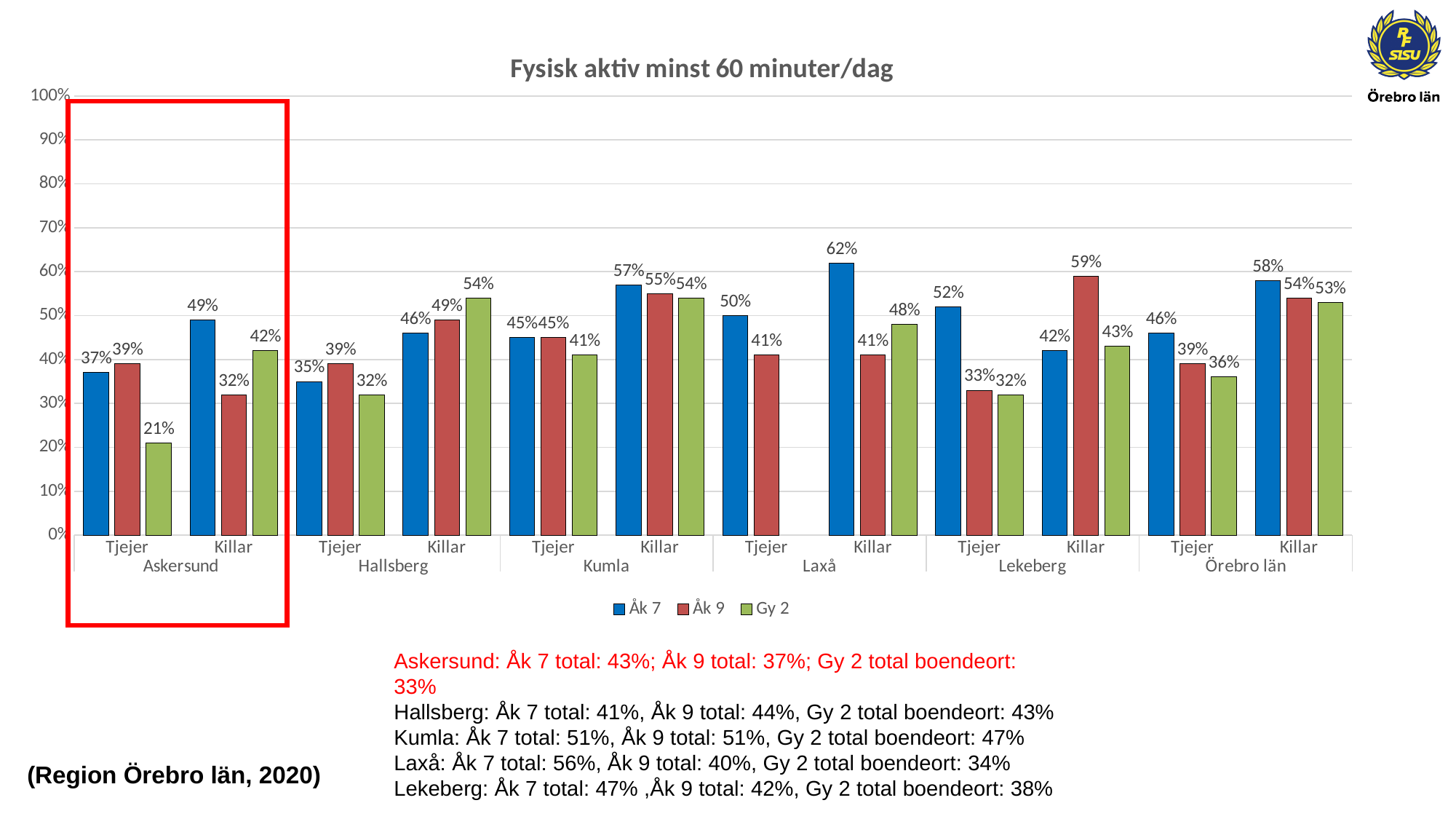
How many municipalities/regions are shown on the x axis? 6 What is the Åk 7 value for Killar in Laxå? 62% Which group has the lowest Gy 2 value? Tjejer, Askersund Which is larger for Killar in Hallsberg: the Åk 7 value or the Gy 2 value? Gy 2 What is the Gy 2 value for Tjejer in Askersund? 21% Which group has the highest Åk 7 value? Killar, Laxå How many series does the legend list? 3 What is the Åk 9 value for Killar in Lekeberg? 59% Is the Åk 9 value for Tjejer in Lekeberg greater or less than 40%? less What kind of chart is shown? bar chart What is the difference between the Åk 7 values for Killar and Tjejer in Örebro län? 12% What is the title of the chart? Fysisk aktiv minst 60 minuter/dag